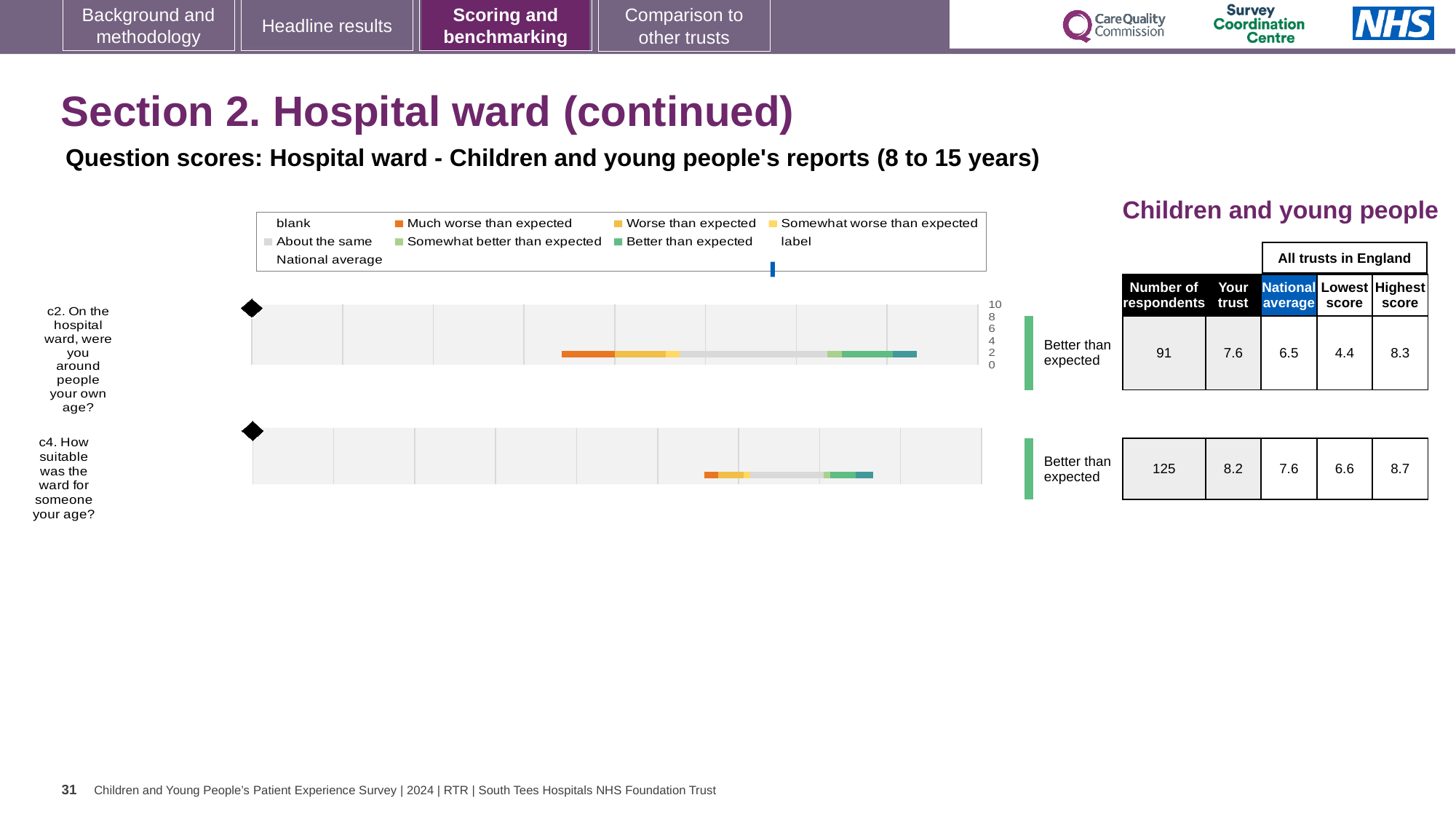
What is the highest score among all trusts in England for question c2? 8.3 For question c4, how much higher is the 'Your trust' score than the national average? 0.6 How many survey questions are plotted on the slide? 2 Which legend entry is shown in orange? Much worse than expected What benchmark rating is shown next to the chart for question c2? Better than expected How many respondents answered question c2? 91 What is the lowest score among all trusts in England for question c4? 6.6 What is the difference between the highest and lowest scores for question c2? 3.9 What is the national average score for question c4 (How suitable was the ward for someone your age?)? 7.6 What is the 'Your trust' score for question c2 (On the hospital ward, were you around people your own age?)? 7.6 What kind of chart is used to show the question scores for c2 and c4? bar chart Which question has the higher 'Your trust' score, c2 or c4? c4